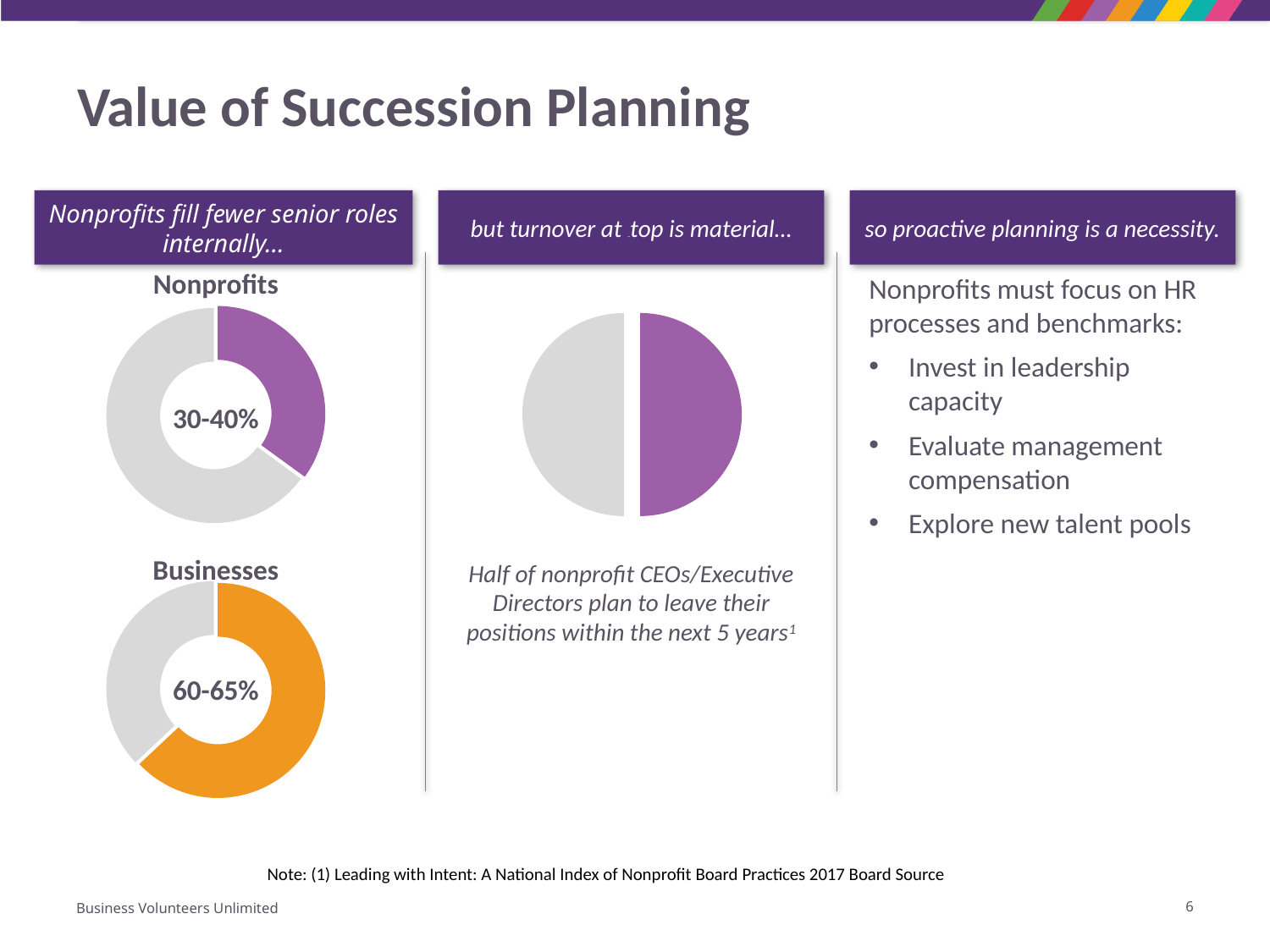
What colour is the highlighted segment of the Businesses donut chart? orange How many donut charts are shown in the left column of the slide? 2 Which chart shows the larger highlighted share, the Nonprofits donut chart or the Businesses donut chart? Businesses On the Businesses donut chart, what value is printed in the centre? 60-65% What kind of chart is the Nonprofits chart on the left of the slide? donut chart On the Nonprofits donut chart, what value is printed in the centre? 30-40% On the Nonprofits donut chart, is the highlighted (purple) share greater or less than 50%? less How many slices does the pie chart in the middle column have? 2 What colour is the highlighted segment of the Nonprofits donut chart? purple On the Businesses donut chart, is the highlighted (orange) share greater or less than 50%? greater What kind of chart is shown in the middle column of the slide? pie chart